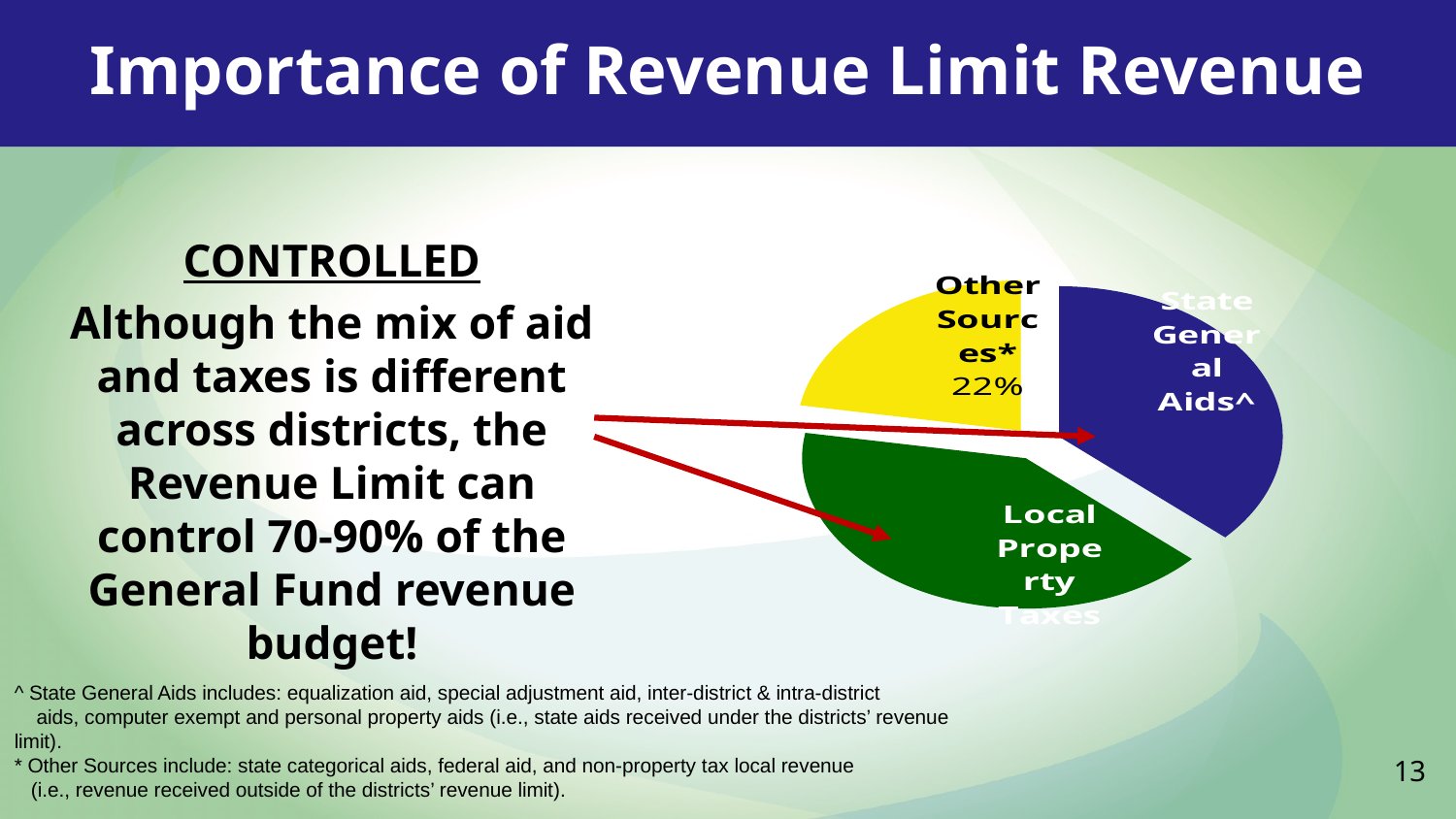
What share of the pie does the Other Sources* slice represent? 22% What percentage of the pie is labelled for Other Sources*? 22% Which slice of the pie chart is the smallest? Other Sources* Which slice is larger, Local Property Taxes or Other Sources*? Local Property Taxes Which slice is larger, State General Aids^ or Other Sources*? State General Aids^ What colour is the Other Sources* slice in the pie chart? yellow What colour is the Local Property Taxes slice in the pie chart? green What kind of chart is shown on the slide? pie chart How many slices does the pie chart have? 3